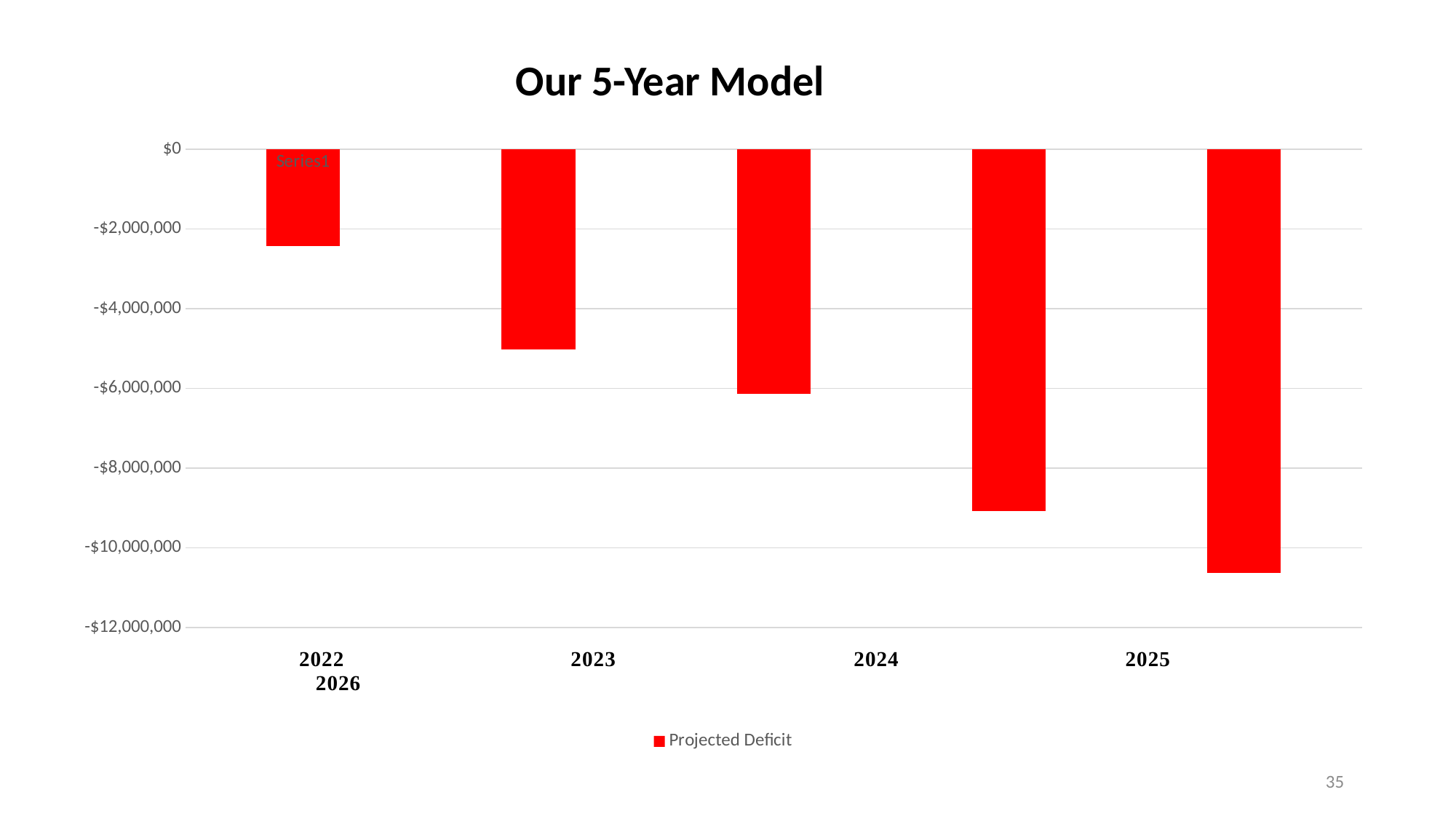
How many bars are plotted in the chart? 5 What kind of chart is shown on the slide? Bar chart Is the value for 2025 greater or less than -8,000,000? less What is the title of the chart? Our 5-Year Model Is the value for 2022 greater or less than -2,000,000? less Do the values rise or fall from 2022 to the rightmost bar? fall Which bar has the lowest value (the largest projected deficit)? The rightmost bar (2026) How many series does the legend list? 1 Is the value for 2023 greater or less than -4,000,000? less Which year has the value closest to $0 (the highest value)? 2022 What series name does the legend show? Projected Deficit